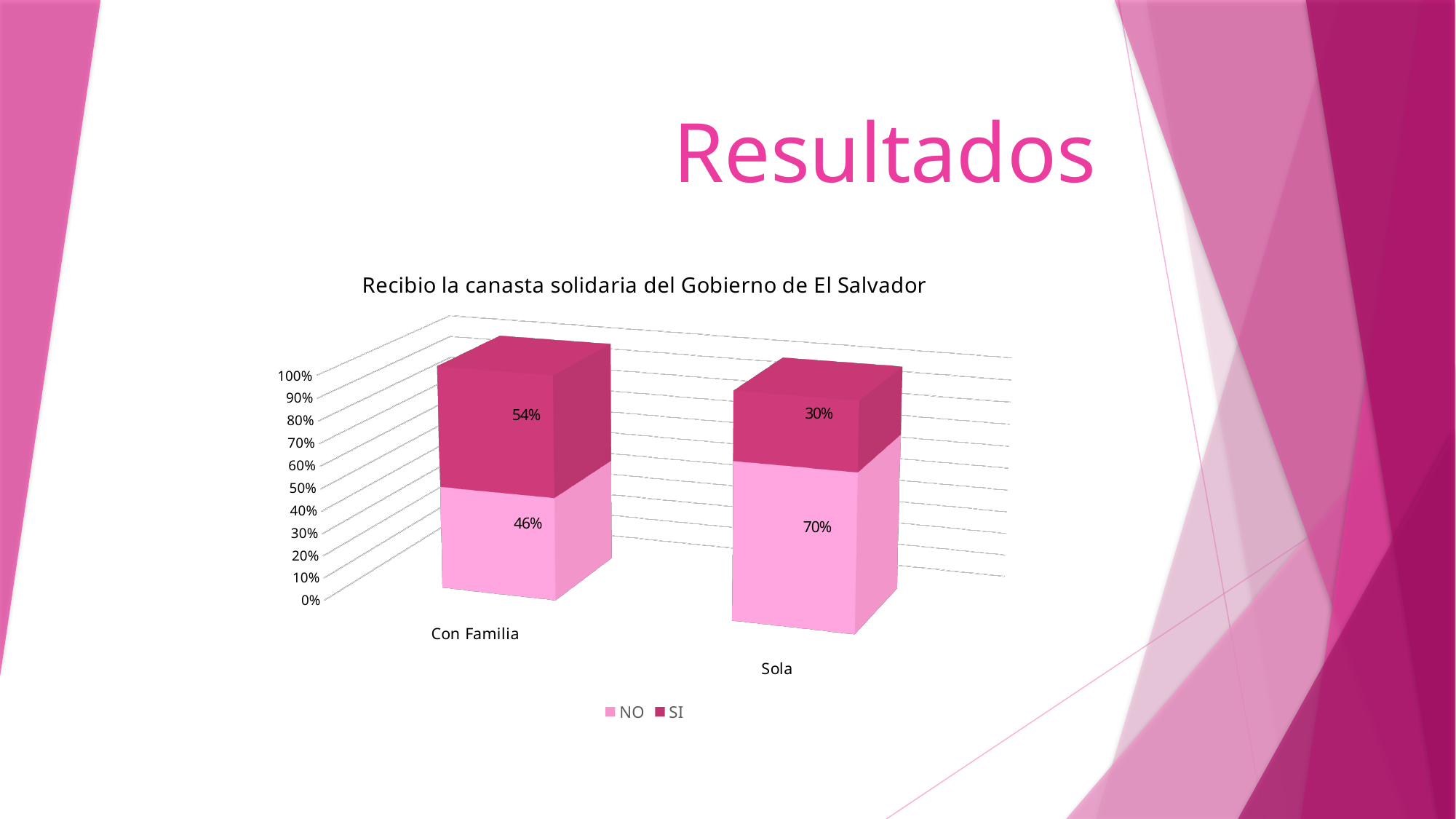
What is the SI value for Con Familia? 54% Is the SI value for Con Familia larger or smaller than the SI value for Sola? larger What is the title of the chart? Recibio la canasta solidaria del Gobierno de El Salvador What kind of chart is shown? stacked bar chart Which category has the higher SI value? Con Familia What is the NO value for Con Familia? 46% How many series does the legend list? 2 What is the difference between the NO values for Sola and Con Familia? 24% What is the NO value for Sola? 70% Which category has the lower NO value? Con Familia How many categories are shown on the x axis? 2 What is the SI value for Sola? 30%